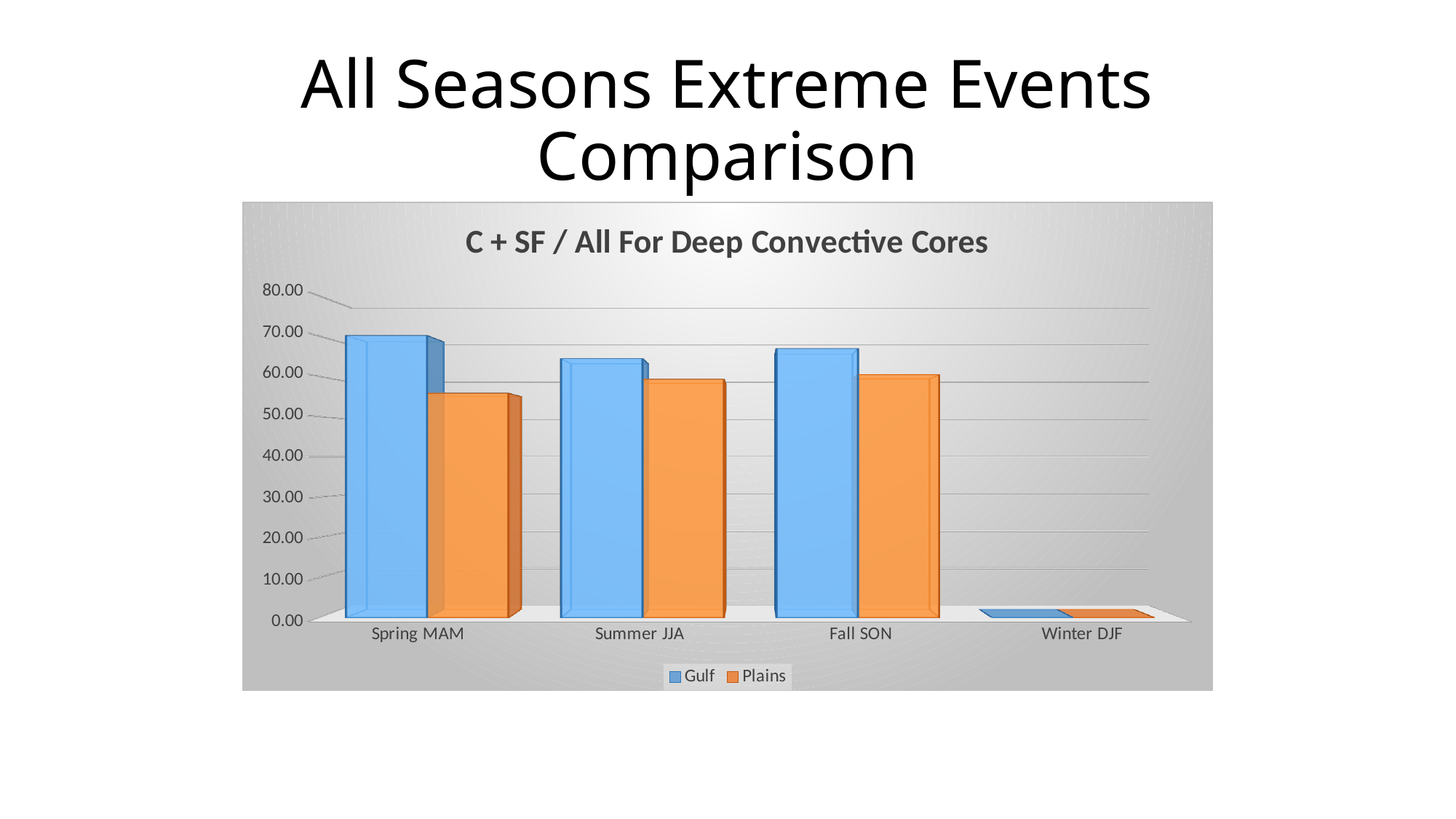
For Spring MAM, which is larger, Gulf or Plains? Gulf Which season has the lowest value for Gulf? Winter DJF Which series is shown in orange in the chart? Plains How many series does the chart legend list? 2 What kind of chart is shown on the slide? bar chart Is the Gulf value for Winter DJF greater or less than 10.00? less Is the Plains value for Spring MAM greater or less than 60.00? less Is the Gulf value for Spring MAM greater or less than 60.00? greater For Gulf, which is larger, Spring MAM or Summer JJA? Spring MAM Which season has the lowest value for Plains? Winter DJF How many seasons (categories) are shown on the x axis of the chart? 4 What is the title of the chart? C + SF / All For Deep Convective Cores